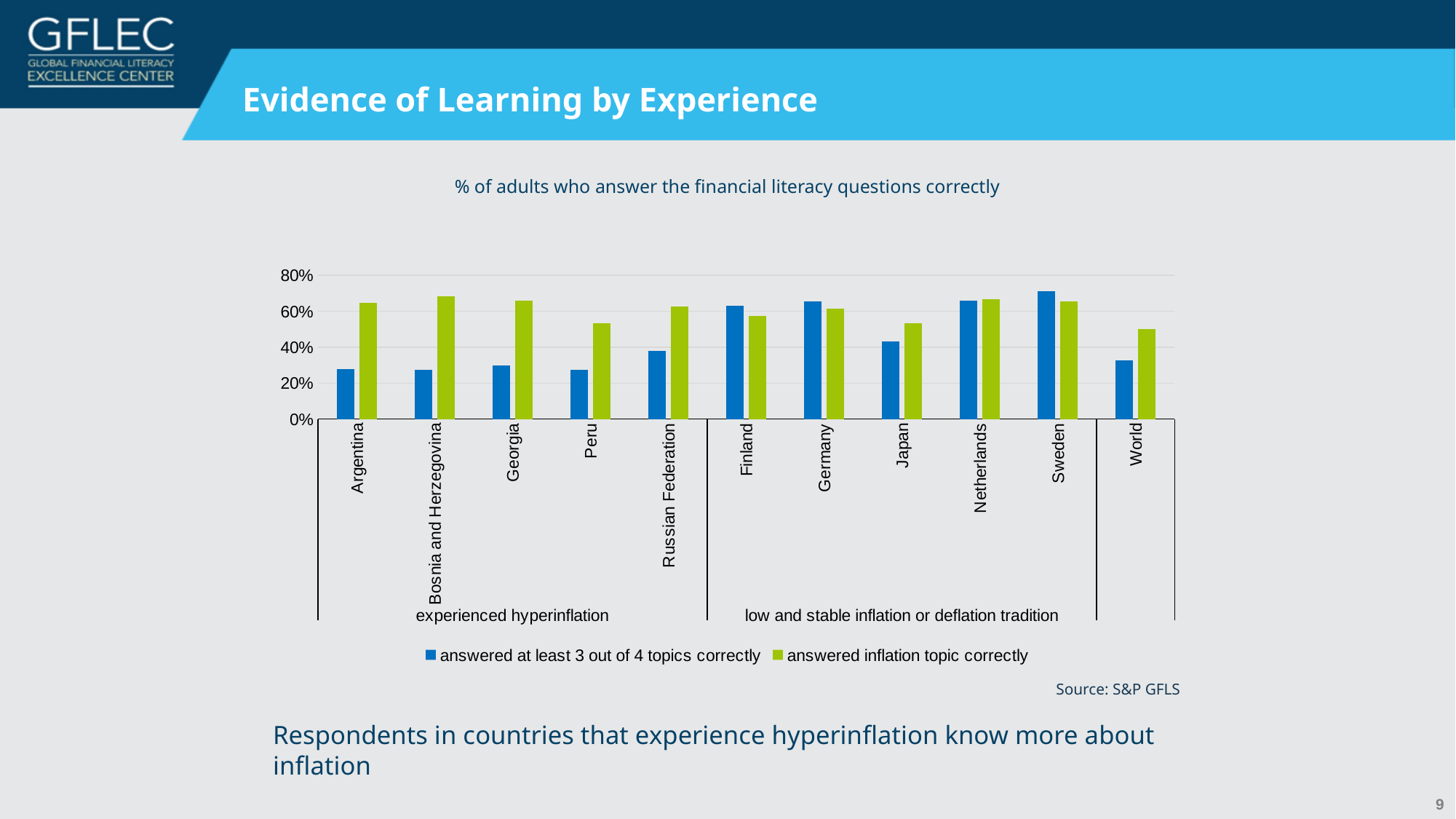
Is the value for Sweden for 'answered at least 3 out of 4 topics correctly' greater or less than 60%? greater For Sweden, which is larger: 'answered at least 3 out of 4 topics correctly' or 'answered inflation topic correctly'? answered at least 3 out of 4 topics correctly What kind of chart is shown on the slide? bar chart What are the two country group labels shown below the x axis? experienced hyperinflation; low and stable inflation or deflation tradition Is the value for Argentina for 'answered at least 3 out of 4 topics correctly' greater or less than 40%? less Is the value for World for 'answered at least 3 out of 4 topics correctly' greater or less than 40%? less How many countries or regions are shown on the x axis? 11 For Argentina, which is larger: 'answered at least 3 out of 4 topics correctly' or 'answered inflation topic correctly'? answered inflation topic correctly What is the title of the chart? % of adults who answer the financial literacy questions correctly Which country has the highest value for 'answered at least 3 out of 4 topics correctly'? Sweden How many series does the legend list? 2